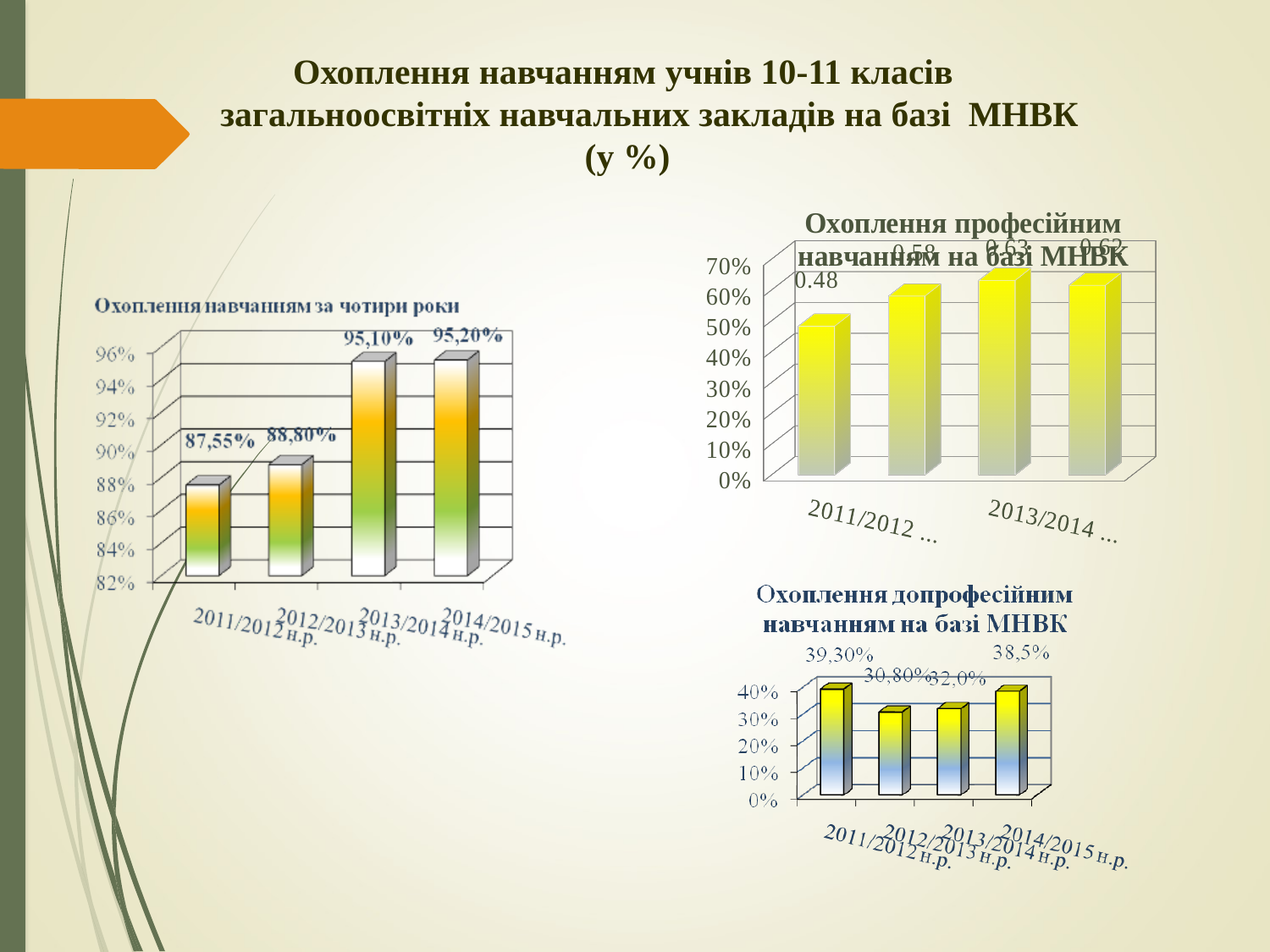
What type of chart is the one titled "Охоплення допрофесійним навчанням на базі МНВК"? bar chart In the chart titled "Охоплення допрофесійним навчанням на базі МНВК", which year has the highest value? 2011/2012 н.р. In the chart titled "Охоплення професійним навчанням на базі МНВК", is the value for 2011/2012 greater or less than 50%? less In the chart titled "Охоплення навчанням за чотири роки", which year has the lowest value? 2011/2012 н.р. In the chart titled "Охоплення професійним навчанням на базі МНВК", what is the data label on the bar for 2013/2014? 0.63 In the chart titled "Охоплення допрофесійним навчанням на базі МНВК", what is the value for 2012/2013 н.р.? 30,80% In the chart titled "Охоплення навчанням за чотири роки", what is the value for 2013/2014 н.р.? 95,10% In the chart titled "Охоплення навчанням за чотири роки", what is the difference between the values for 2013/2014 н.р. and 2012/2013 н.р.? 6,30% In the chart titled "Охоплення професійним навчанням на базі МНВК", what is the data label on the bar for 2011/2012? 0.48 In the chart titled "Охоплення навчанням за чотири роки", what is the value for 2011/2012 н.р.? 87,55% How many bars are shown in the chart titled "Охоплення навчанням за чотири роки"? 4 In the chart titled "Охоплення навчанням за чотири роки", do the values rise or fall from 2011/2012 to 2014/2015? rise